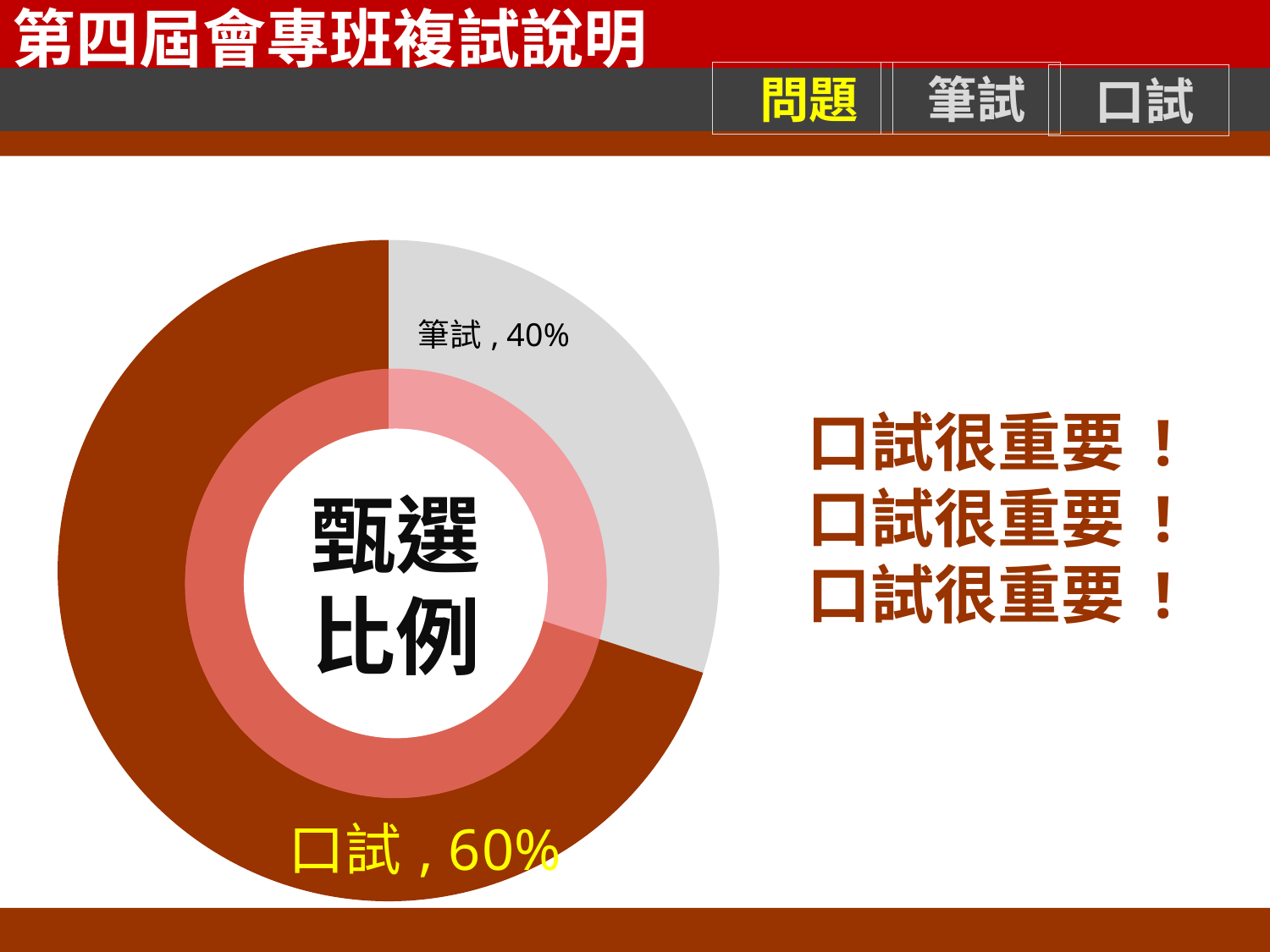
Which category has the smallest share of the pie? 筆試 What is the difference in percentage points between the 口試 and 筆試 shares? 20% What kind of chart is shown on the slide? pie chart Which category has the largest share of the pie? 口試 What colour is the 筆試 slice of the pie chart? grey Is the share for 口試 greater or less than 50%? greater What share of the pie does 口試 have? 60% What share of the pie does 筆試 have? 40% What is the total of the two shares shown in the pie chart? 100% What text is shown in the centre of the pie chart? 甄選比例 How many categories are shown in the pie chart? 2 Which is larger, the share for 口試 or the share for 筆試? 口試